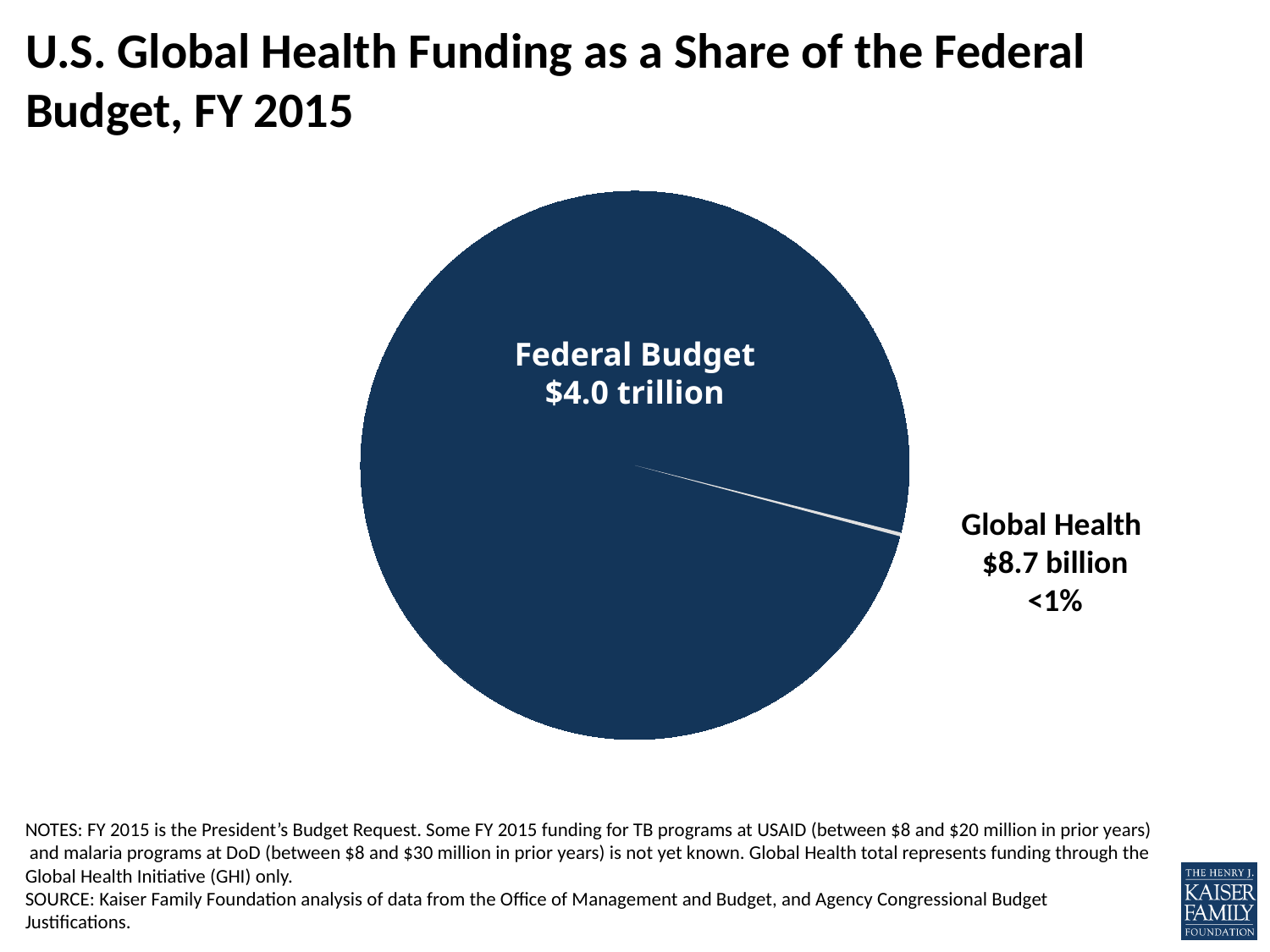
What is the value shown for the Global Health slice? $8.7 billion What share of the pie does Global Health represent, as labelled on the slide? <1% Which slice of the pie is the smallest? Global Health What kind of chart is shown on the slide? Pie chart Which fiscal year does the chart cover? FY 2015 What is the value shown for the Federal Budget slice? $4.0 trillion Which slice of the pie is the largest? Federal Budget Which slice is larger, Federal Budget or Global Health? Federal Budget How many slices does the pie chart have? 2 What is the title of the chart on the slide? U.S. Global Health Funding as a Share of the Federal Budget, FY 2015